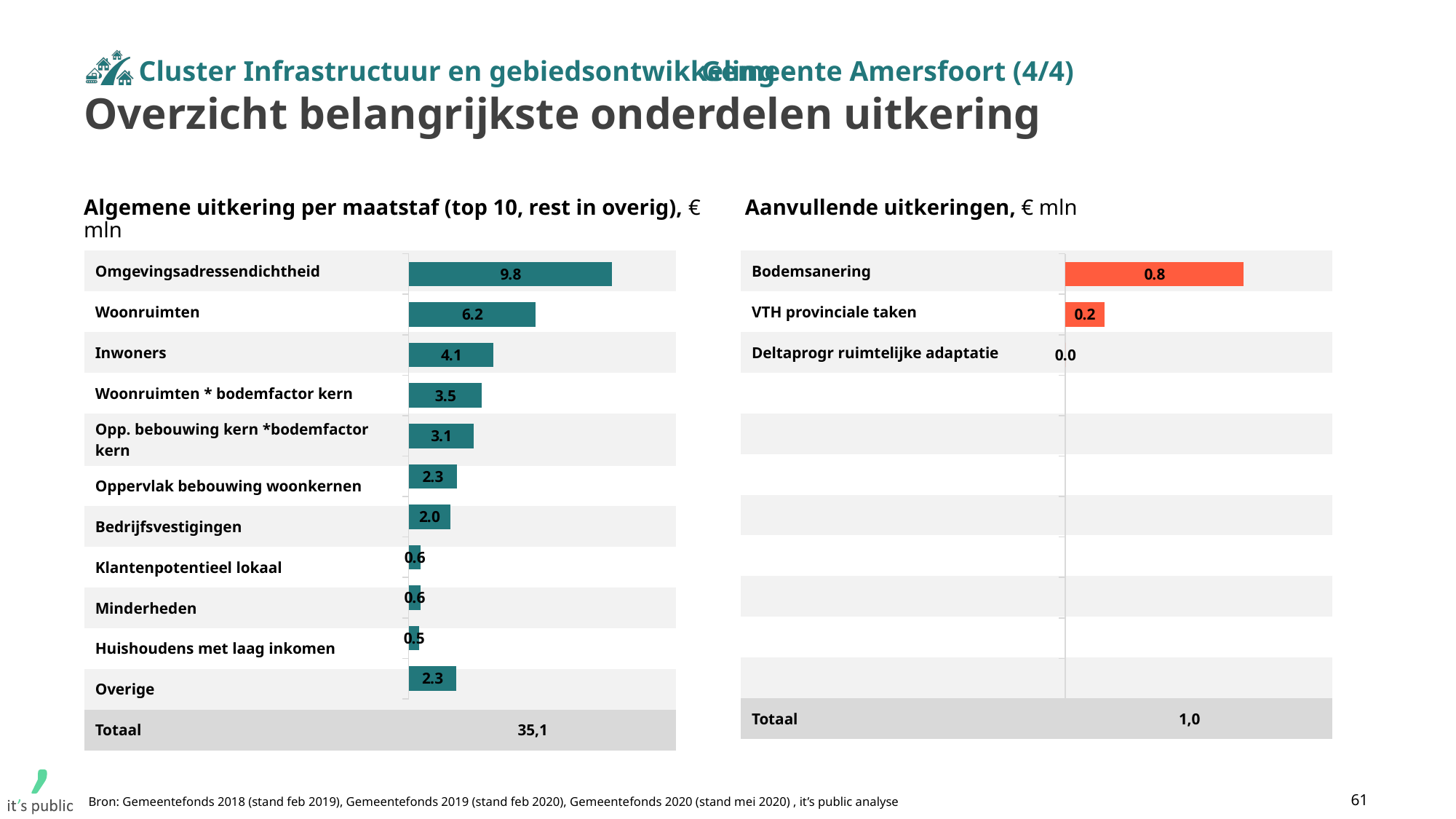
What kind of chart is the 'Aanvullende uitkeringen' chart? Bar chart How many categories (bars) are shown in the 'Algemene uitkering per maatstaf' chart, including Overige? 11 In the 'Aanvullende uitkeringen' chart, what is the value for Deltaprogr ruimtelijke adaptatie? 0.0 In the 'Algemene uitkering per maatstaf' chart, which category has the lowest value? Huishoudens met laag inkomen In the 'Algemene uitkering per maatstaf' chart, which category has the highest value? Omgevingsadressendichtheid In the 'Algemene uitkering per maatstaf' chart, what is the value for Woonruimten? 6.2 What total is shown at the bottom of the 'Algemene uitkering per maatstaf' chart? 35,1 In the 'Algemene uitkering per maatstaf' chart, which is larger: Woonruimten * bodemfactor kern or Oppervlak bebouwing woonkernen? Woonruimten * bodemfactor kern In the 'Aanvullende uitkeringen' chart, what is the value for Bodemsanering? 0.8 In the 'Algemene uitkering per maatstaf' chart, what is the value for Bedrijfsvestigingen? 2.0 In the 'Aanvullende uitkeringen' chart, what is the difference between Bodemsanering and VTH provinciale taken? 0.6 In the 'Algemene uitkering per maatstaf' chart, what is the difference between Omgevingsadressendichtheid and Inwoners? 5.7